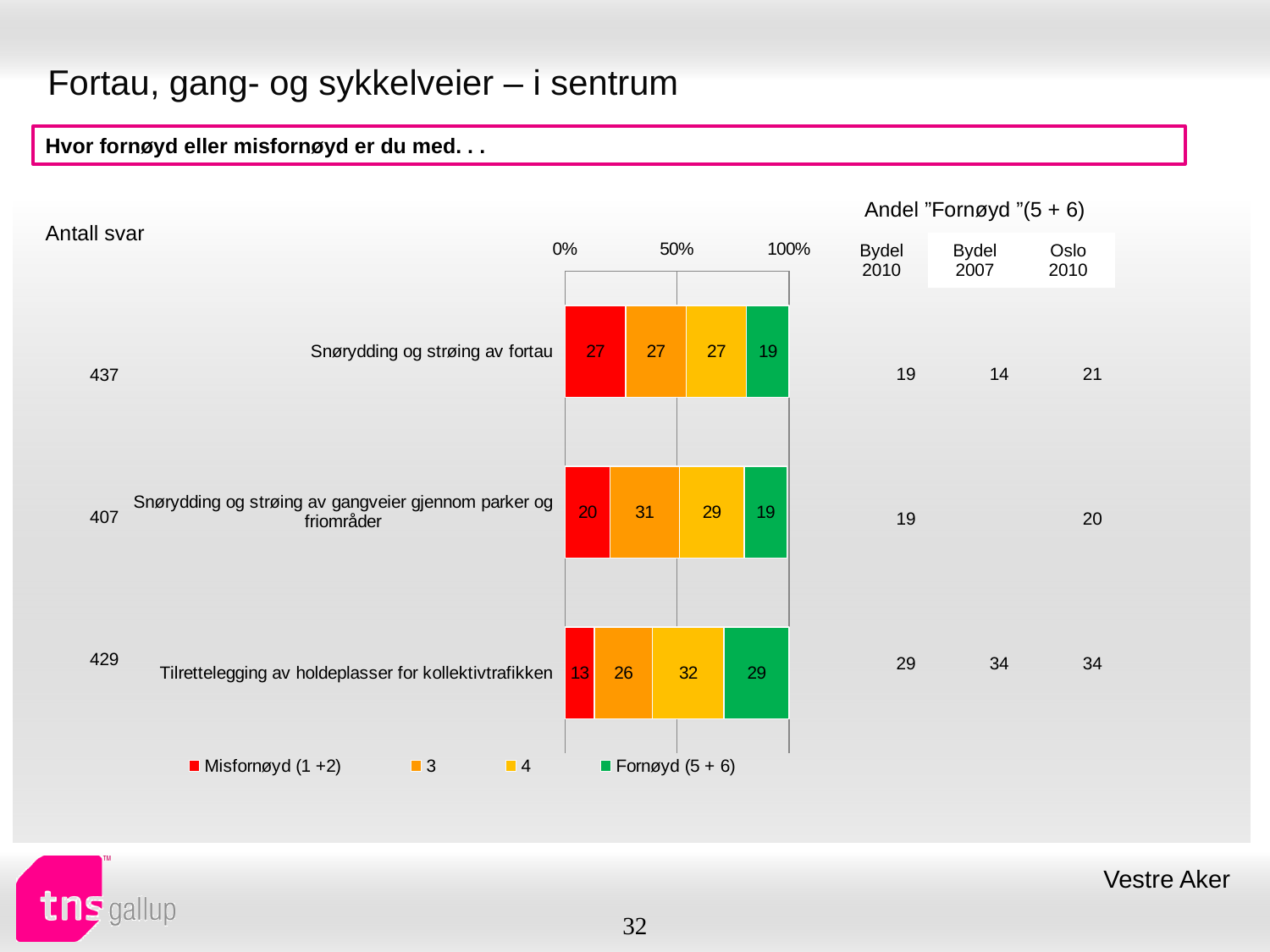
How many series does the legend list? 4 What type of chart is shown on the slide? stacked bar chart What is the difference between the 'Fornøyd (5 + 6)' value for 'Tilrettelegging av holdeplasser for kollektivtrafikken' and for 'Snørydding og strøing av fortau'? 10 Which category has the lowest 'Misfornøyd (1 +2)' value? Tilrettelegging av holdeplasser for kollektivtrafikken What is the total of the stacked bar for 'Snørydding og strøing av gangveier gjennom parker og friområder'? 99 What is the value of 'Misfornøyd (1 +2)' for 'Snørydding og strøing av fortau'? 27 Which category has the highest 'Misfornøyd (1 +2)' value? Snørydding og strøing av fortau How many categories are plotted in the chart? 3 What colour represents the 'Fornøyd (5 + 6)' series in the chart? green Which is larger: the series '4' value for 'Tilrettelegging av holdeplasser for kollektivtrafikken' or for 'Snørydding og strøing av fortau'? Tilrettelegging av holdeplasser for kollektivtrafikken What is the value of series '3' for 'Snørydding og strøing av gangveier gjennom parker og friområder'? 31 What is the value of 'Fornøyd (5 + 6)' for 'Tilrettelegging av holdeplasser for kollektivtrafikken'? 29